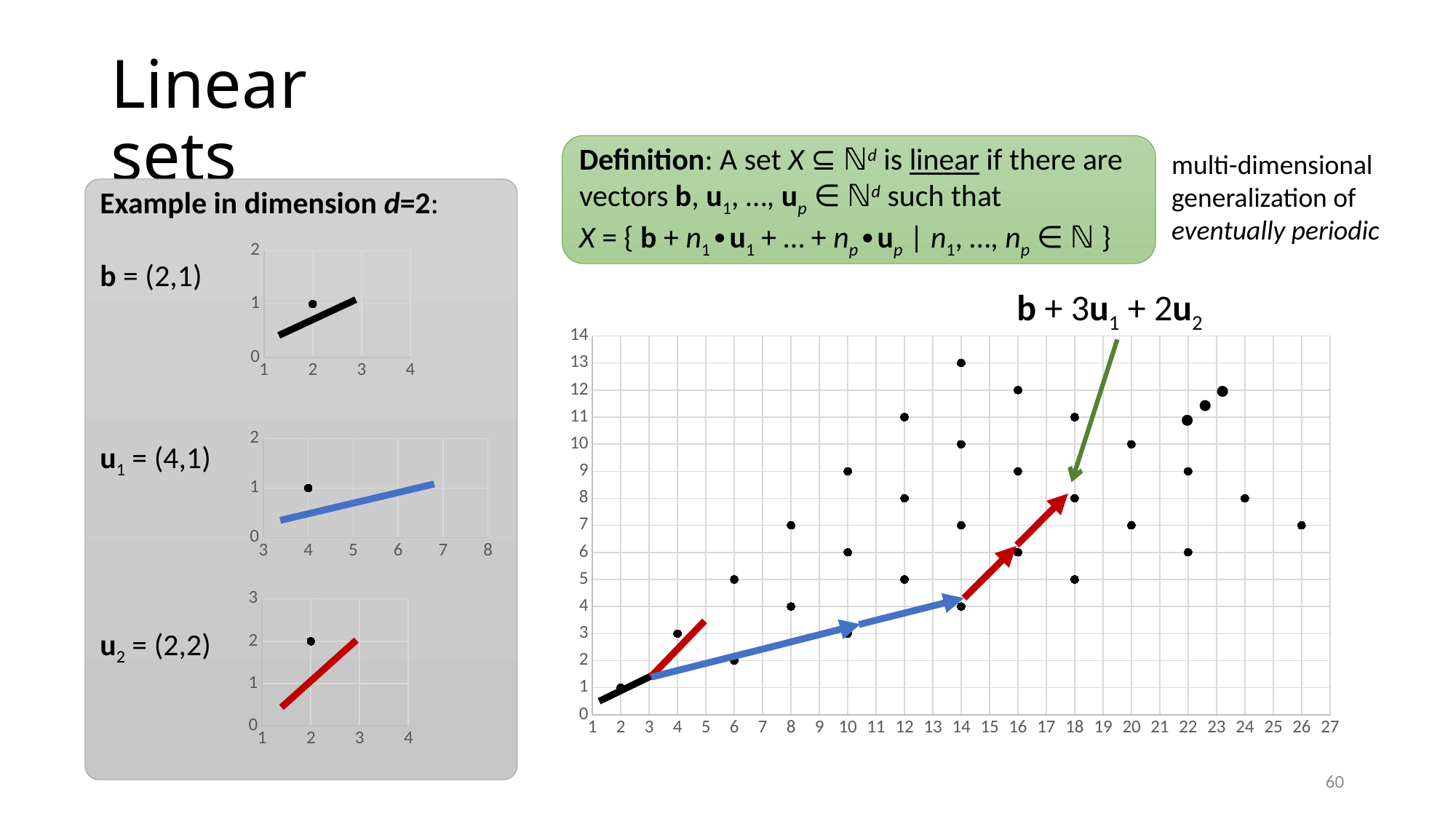
On the large chart on the right, what is the y value of the highest plotted point? 13 On the large chart on the right, what is the highest value shown on the x axis? 27 On the large chart on the right, is the y value of the point at x = 26 greater or less than 10? less On the large chart on the right, what is the y value of the lowest plotted point? 1 On the large chart on the right, what is the y value of the point with the largest x value (x = 26)? 7 On the large chart on the right, what is the highest value shown on the y axis? 14 On the large chart on the right, how many points are plotted at x = 14? 4 On the small chart labelled u1 = (4,1), how many points are plotted? 1 On the small chart labelled u2 = (2,2), what is the highest value shown on the y axis? 3 What kind of chart is the large chart on the right of the slide? scatter chart On the large chart on the right, what are the coordinates of the point the green arrow labelled b + 3u1 + 2u2 points to? (18, 8) On the small chart labelled b = (2,1), what are the coordinates of the plotted point? (2, 1)